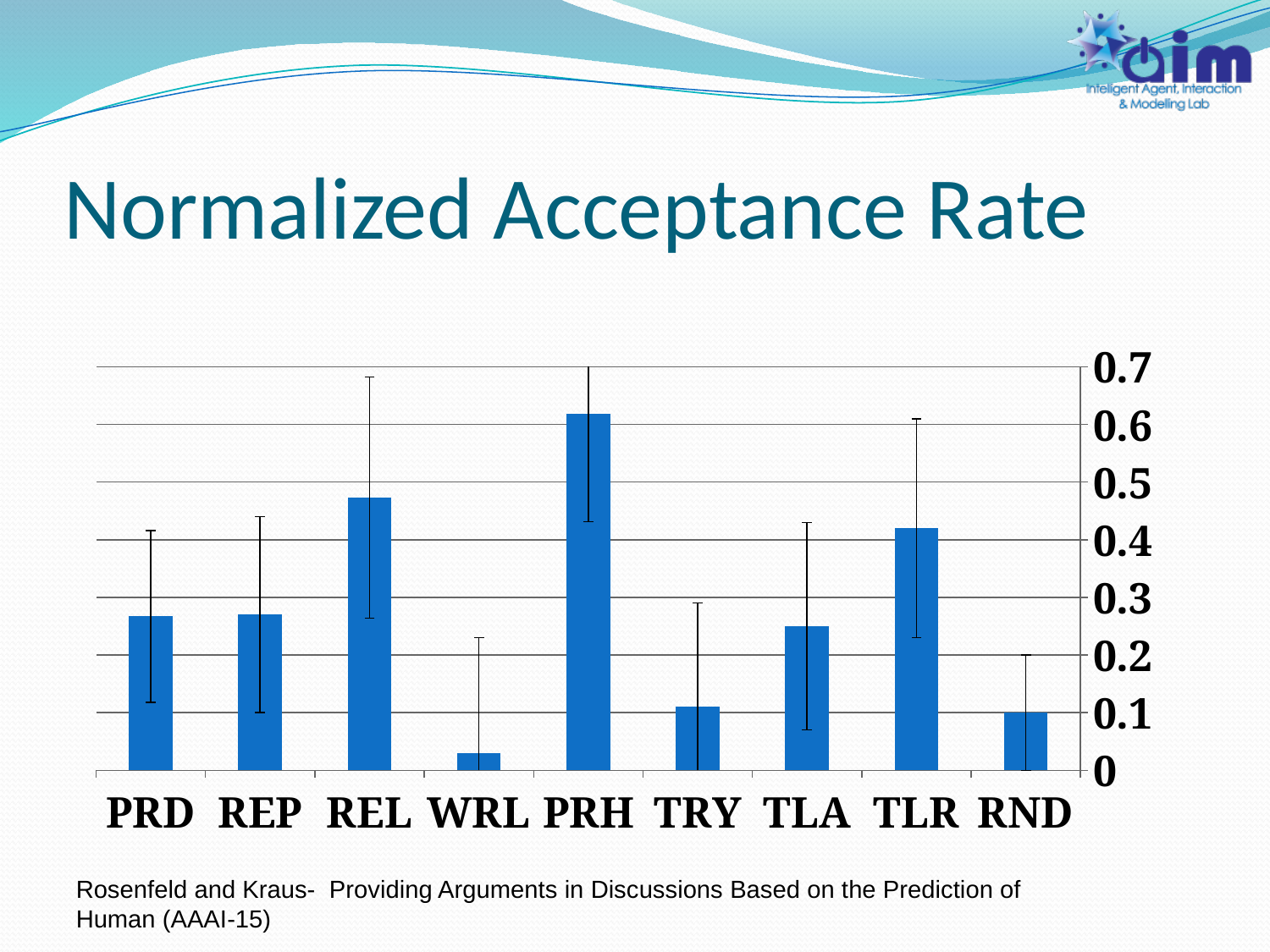
Is the value for TLA greater or less than 0.3? less Is the value for PRH greater or less than 0.5? greater Is the value for REL greater or less than 0.5? less Which category has the highest bar in the chart? PRH What kind of chart is shown on the slide? bar chart Which has the larger value, PRH or REL? PRH How many categories are shown on the x axis of the chart? 9 Which category has the lowest bar in the chart? WRL Which has the larger value, REL or TLR? REL What is the title of the slide containing the chart? Normalized Acceptance Rate